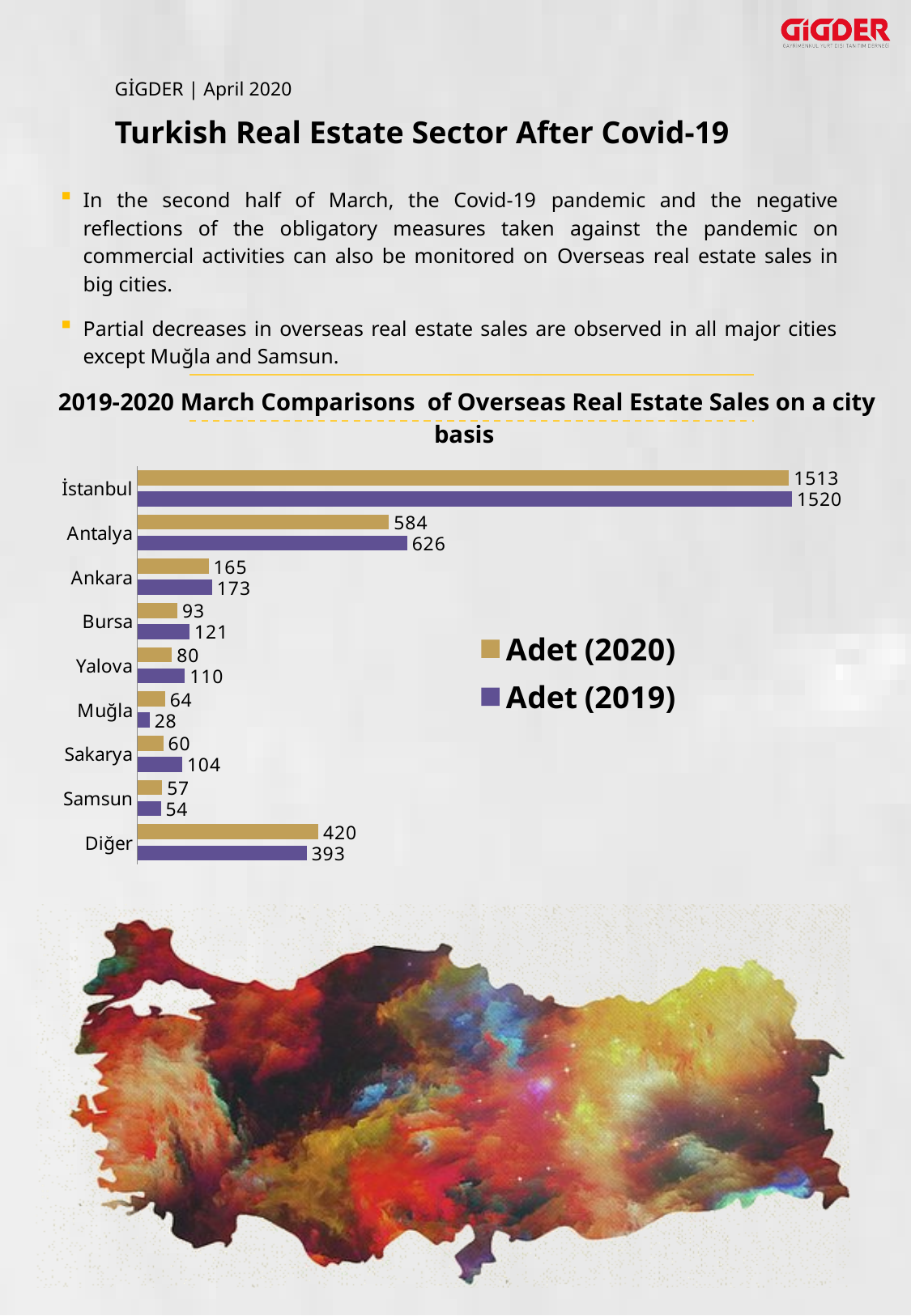
What is the difference between the Adet (2019) and Adet (2020) values for Bursa? 28 Which is larger for Sakarya, Adet (2020) or Adet (2019)? Adet (2019) Which colour represents Adet (2019) in the chart? Purple How many series does the legend list? 2 Which category has the lowest Adet (2019) value? Muğla Which is larger for Samsun, Adet (2020) or Adet (2019)? Adet (2020) What is the Adet (2019) value for Muğla? 28 What kind of chart is shown on the slide? Bar chart Which city has the highest Adet (2020) value? İstanbul What is the Adet (2019) value for Antalya? 626 How many categories are shown on the chart? 9 What is the Adet (2020) value for İstanbul? 1513